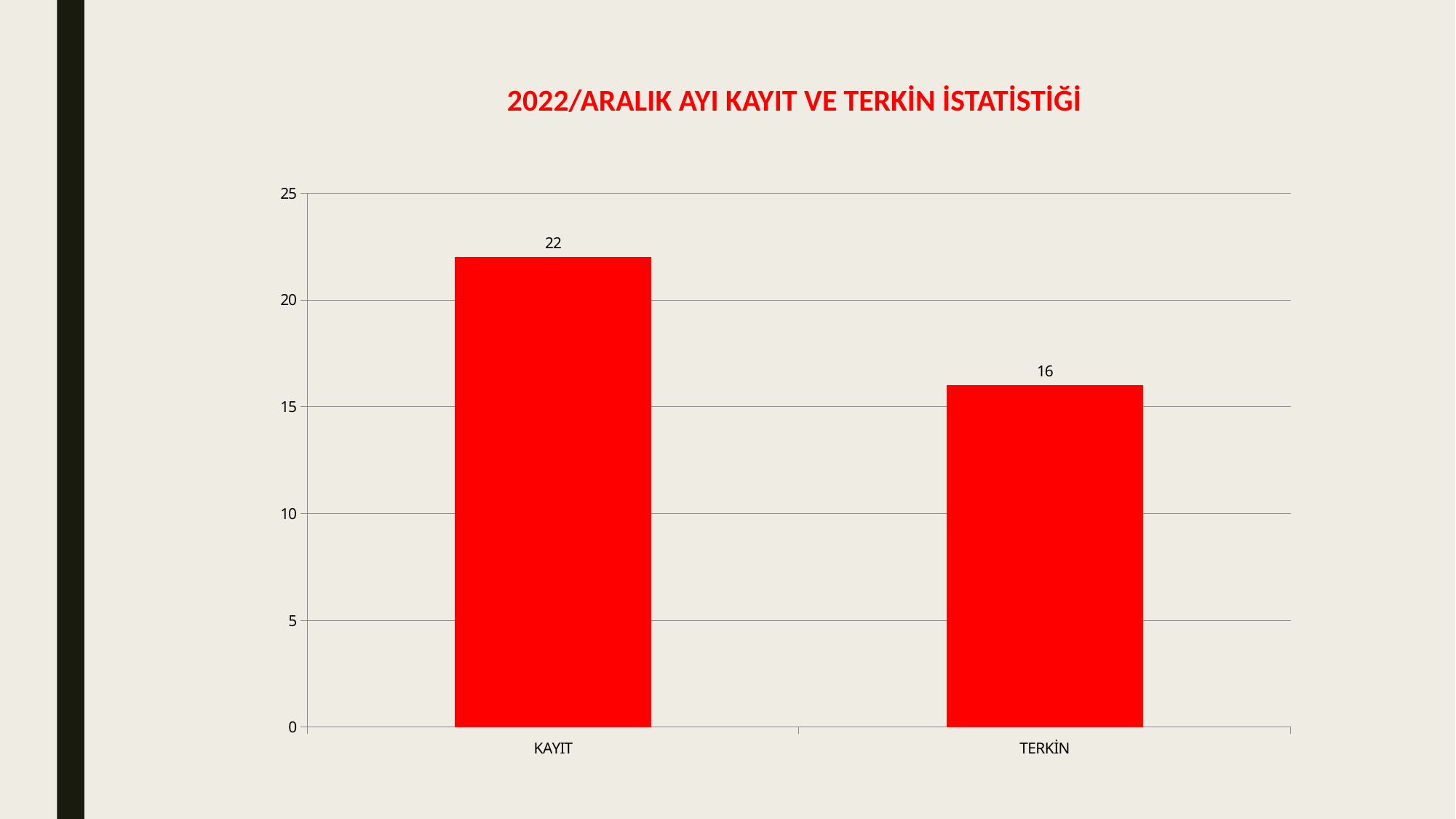
What is the difference between the values for KAYIT and TERKİN? 6 Which is larger, the value for KAYIT or the value for TERKİN? KAYIT What is the title of the chart? 2022/ARALIK AYI KAYIT VE TERKİN İSTATİSTİĞİ What kind of chart is shown on the slide? bar chart What is the value for TERKİN? 16 Which category has the lowest value? TERKİN Is the value for KAYIT greater or less than 20? greater What is the value for KAYIT? 22 Which category has the highest value? KAYIT How many categories are shown on the chart? 2 Is the value for TERKİN greater or less than 20? less What colour are the bars in the chart? red